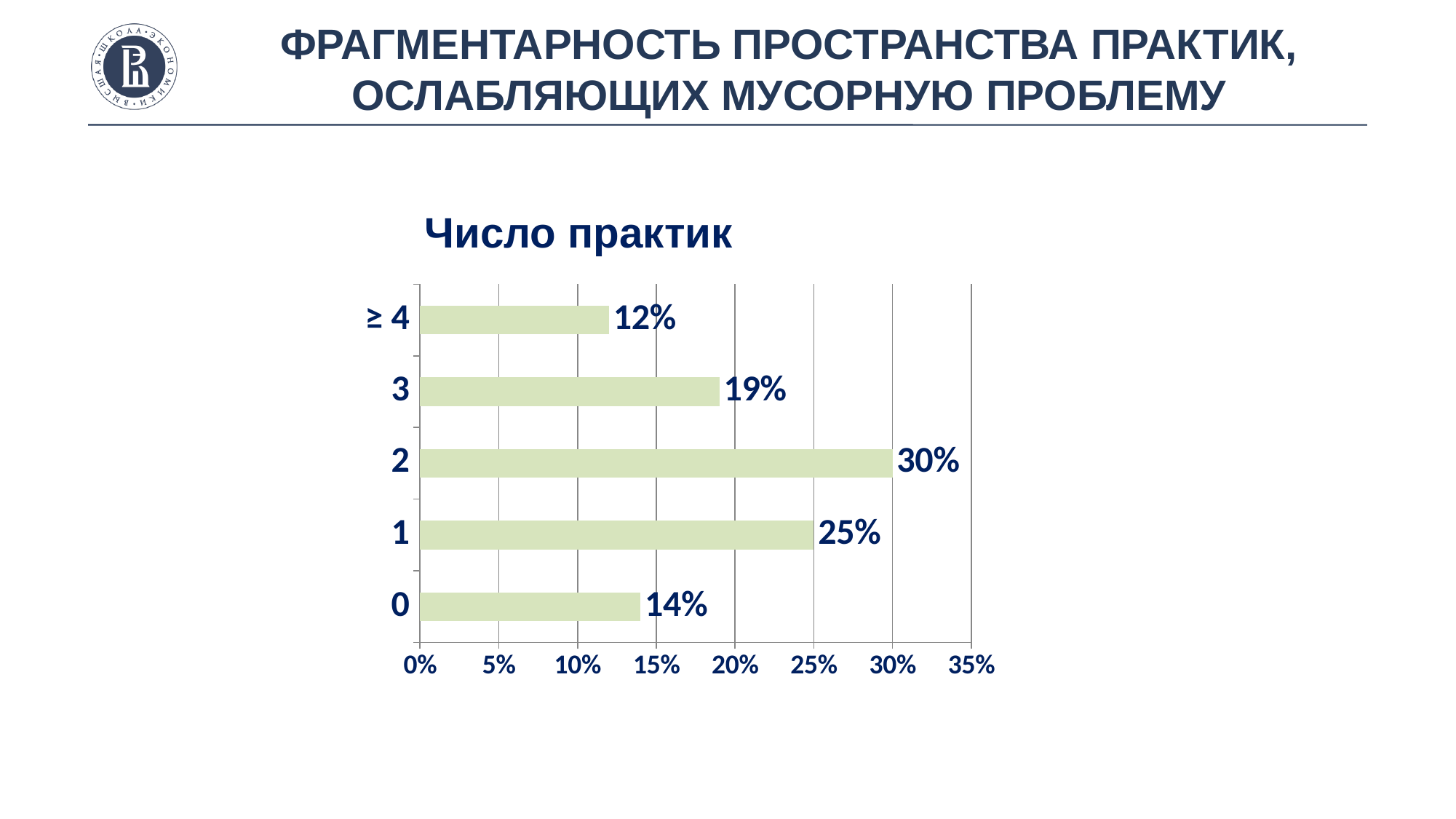
What is the title of the chart? Число практик How many categories are shown in the chart? 5 What is the difference between the values for category 2 and category 1? 5% What kind of chart is shown on the slide? bar chart Which category has the highest value? 2 Which is larger, the value for category 1 or the value for category 3? 1 Is the value for category 1 greater or less than 20%? greater What is the value for category ≥ 4? 12% Which category has the lowest value? ≥ 4 What is the difference between the values for category 3 and category ≥ 4? 7% What is the value for category 0? 14% What is the value for category 2? 30%